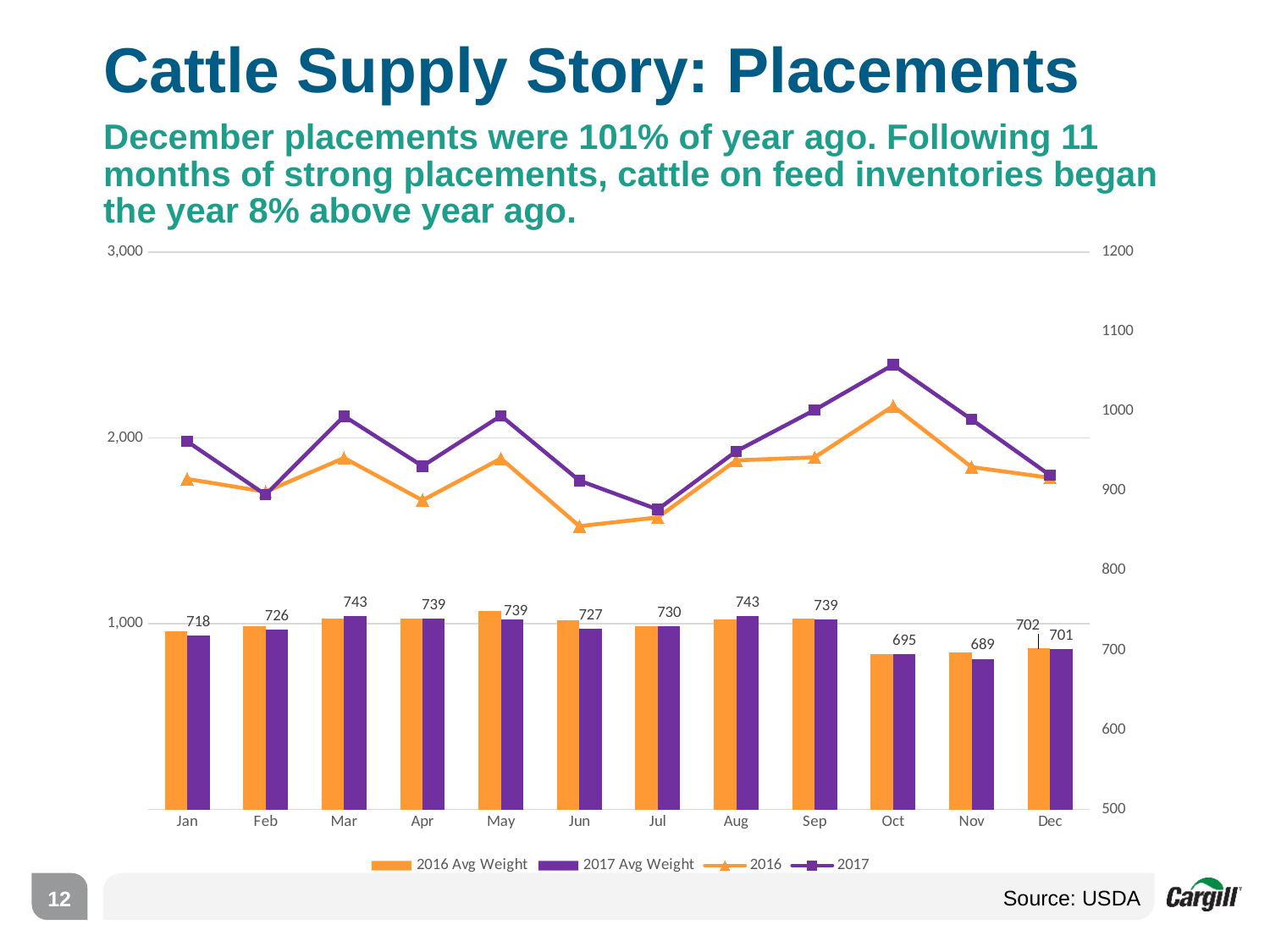
What is the difference between the 2017 Avg Weight in Mar and in Nov? 54 What is the 2017 Avg Weight value for Jan? 718 Is the value of the 2017 line in Oct greater or less than 2,000 on the left axis? greater How many months are shown on the x axis? 12 In which month is the 2017 Avg Weight lowest? Nov Which is larger, the 2017 Avg Weight in Jan or in Feb? Feb What is the 2017 Avg Weight value for Nov? 689 What is the 2016 Avg Weight value for Dec? 702 Does the 2017 line rise or fall from Jul to Oct? rise In which month does the 2017 line reach its highest point? Oct How many series does the legend list? 4 What is the 2017 Avg Weight value for Mar? 743